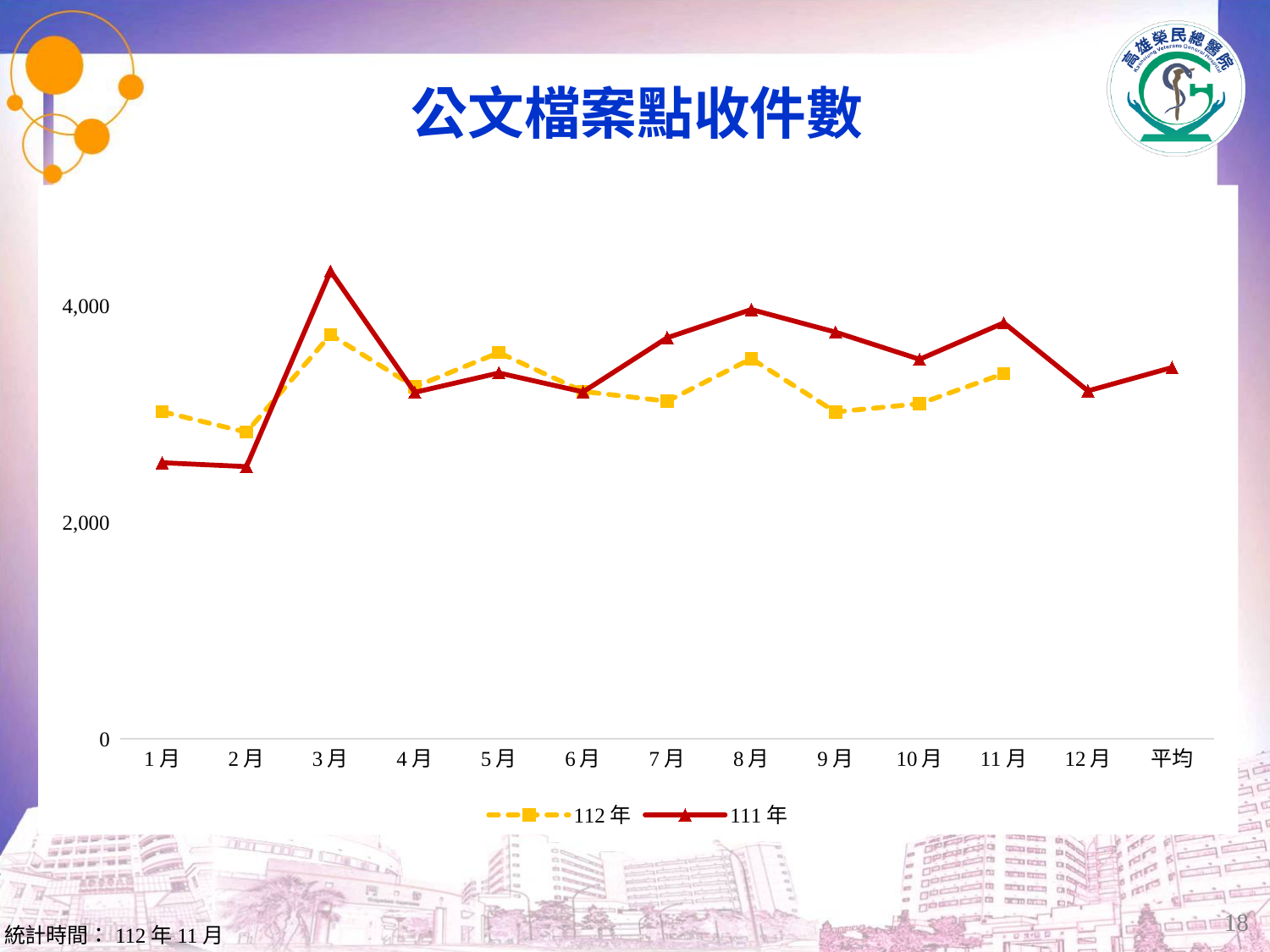
Is the value for 112年 in 2月 greater or less than 4,000? less Is the value for 111年 in 1月 greater or less than 2,000? greater How many categories are shown along the x axis? 13 How many series does the legend list? 2 Does the 111年 series rise or fall from 1月 to 3月? rise In 1月, which series has the higher value, 112年 or 111年? 112年 What is the title of the chart? 公文檔案點收件數 In which month does the 112年 series reach its lowest value? 2月 Is the value for 111年 in 3月 greater or less than 4,000? greater In 8月, which series has the higher value, 112年 or 111年? 111年 In which month does the 111年 series reach its highest value? 3月 What kind of chart is shown on the slide? line chart